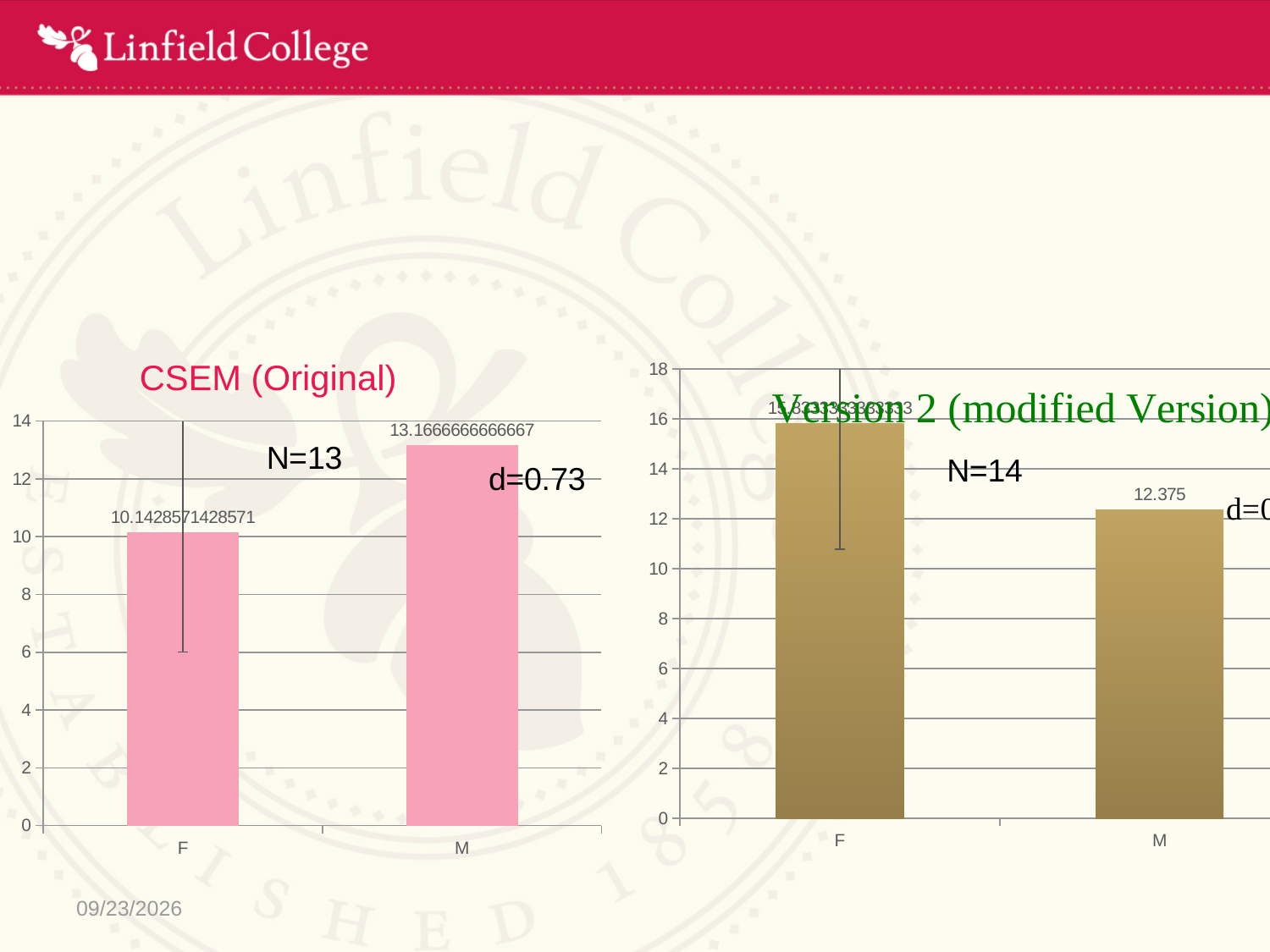
In the Version 2 (modified Version) chart on the right, what is the value for M? 12.375 What is the title of the chart on the left of the slide? CSEM (Original) In the CSEM (Original) chart, which category has the higher value? M In the CSEM (Original) chart, which category has the lowest value? F What kind of chart is the CSEM (Original) chart? bar chart In the Version 2 (modified Version) chart on the right, is the value for M greater or less than 12? greater In the Version 2 (modified Version) chart on the right, which category has the higher value? F In the CSEM (Original) chart, what is the value for F? 10.1428571428571 In the CSEM (Original) chart, how many categories are shown on the x axis? 2 In the CSEM (Original) chart, is the value for F greater or less than 10? greater In the CSEM (Original) chart, what is the value for M? 13.1666666666667 In the Version 2 (modified Version) chart on the right, is the value for F greater or less than 14? greater